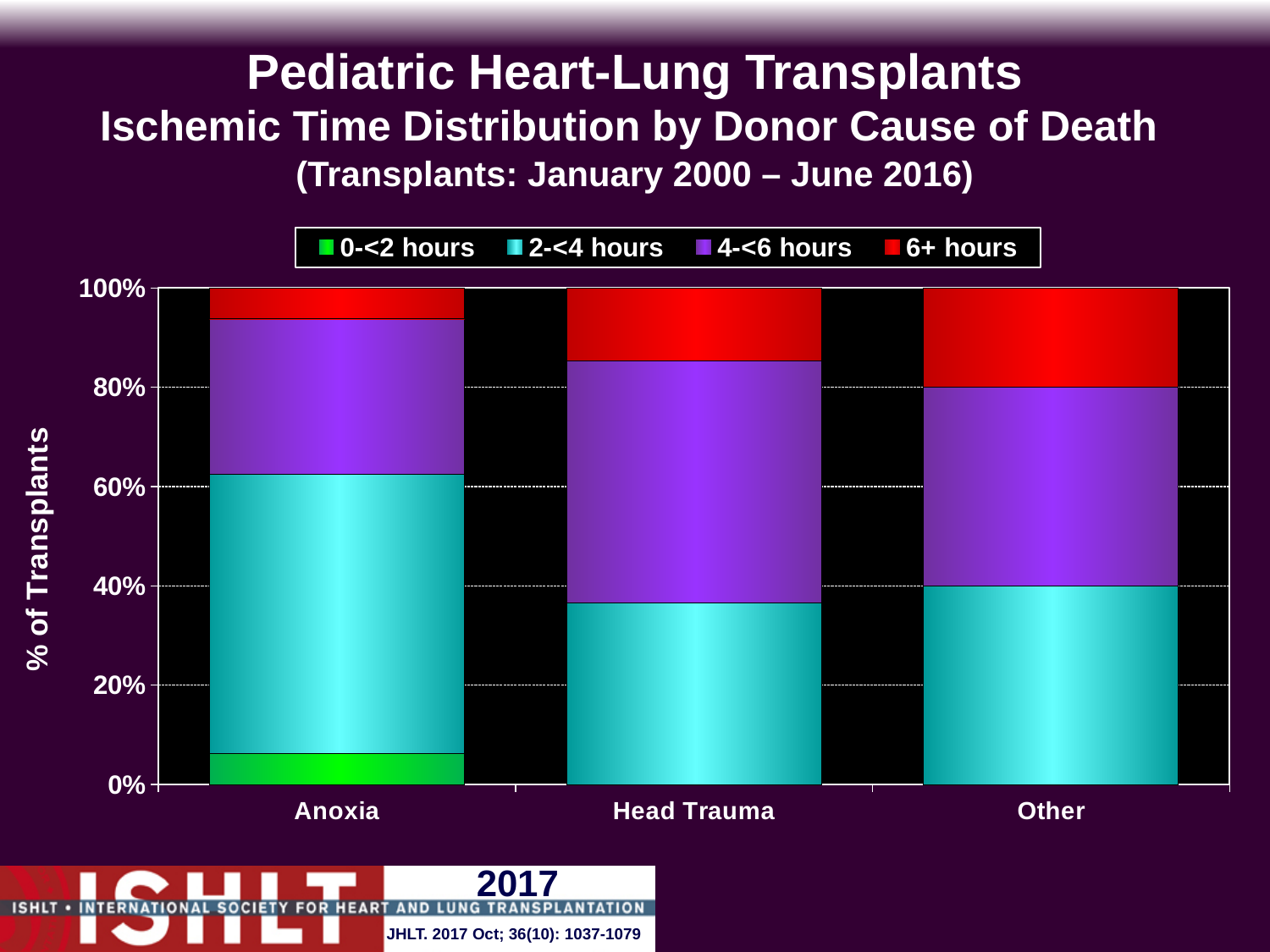
How many donor cause of death categories are shown on the x axis? 3 What kind of chart is shown on the slide? Stacked bar chart Which category has the largest 2-<4 hours share? Anoxia Is the 2-<4 hours share for Anoxia greater or less than 40%? greater Which category has the smallest 6+ hours share? Anoxia What is the label of the y axis? % of Transplants Is the 6+ hours share for Other greater or less than 40%? less Is the 4-<6 hours share for Head Trauma greater or less than 40%? greater Which has the larger 4-<6 hours share, Anoxia or Head Trauma? Head Trauma Which category is the only one with a visible 0-<2 hours segment? Anoxia Which has the larger 6+ hours share, Anoxia or Other? Other How many series does the legend list? 4